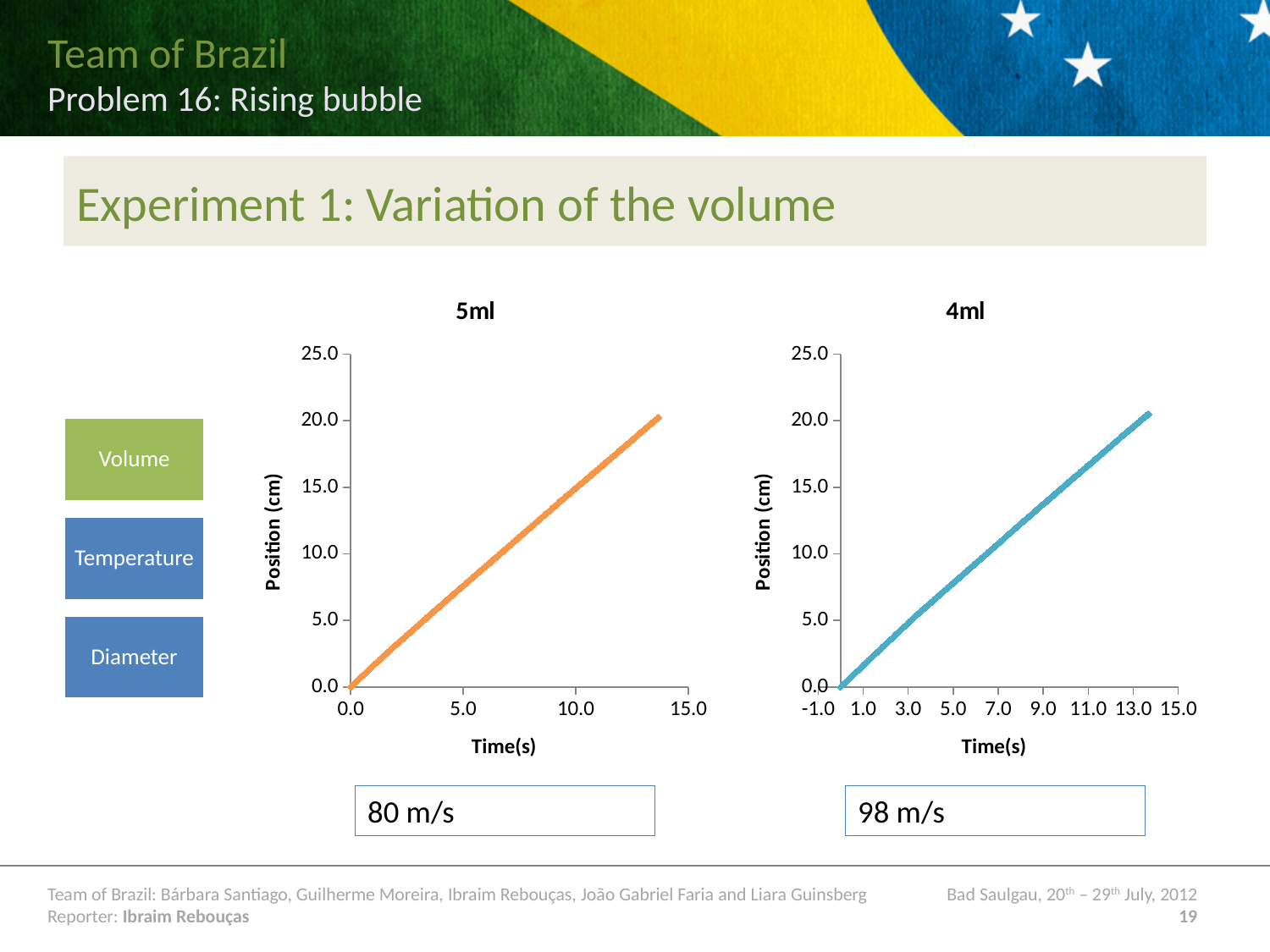
In the chart titled "5ml", is the highest plotted position greater or less than 15.0 cm? greater What is the label of the x axis on the chart titled "4ml"? Time(s) In the chart titled "5ml", is the position at time 10.0 s greater or less than 10.0 cm? greater What kind of chart is the chart titled "4ml"? line chart In the chart titled "4ml", is the position at time 5.0 s greater or less than 5.0 cm? greater What kind of chart is the chart titled "5ml"? line chart In the chart titled "5ml", does the position rise or fall as time increases? rise What is the label of the y axis on the chart titled "5ml"? Position (cm) In the chart titled "4ml", does the position rise or fall as time increases? rise